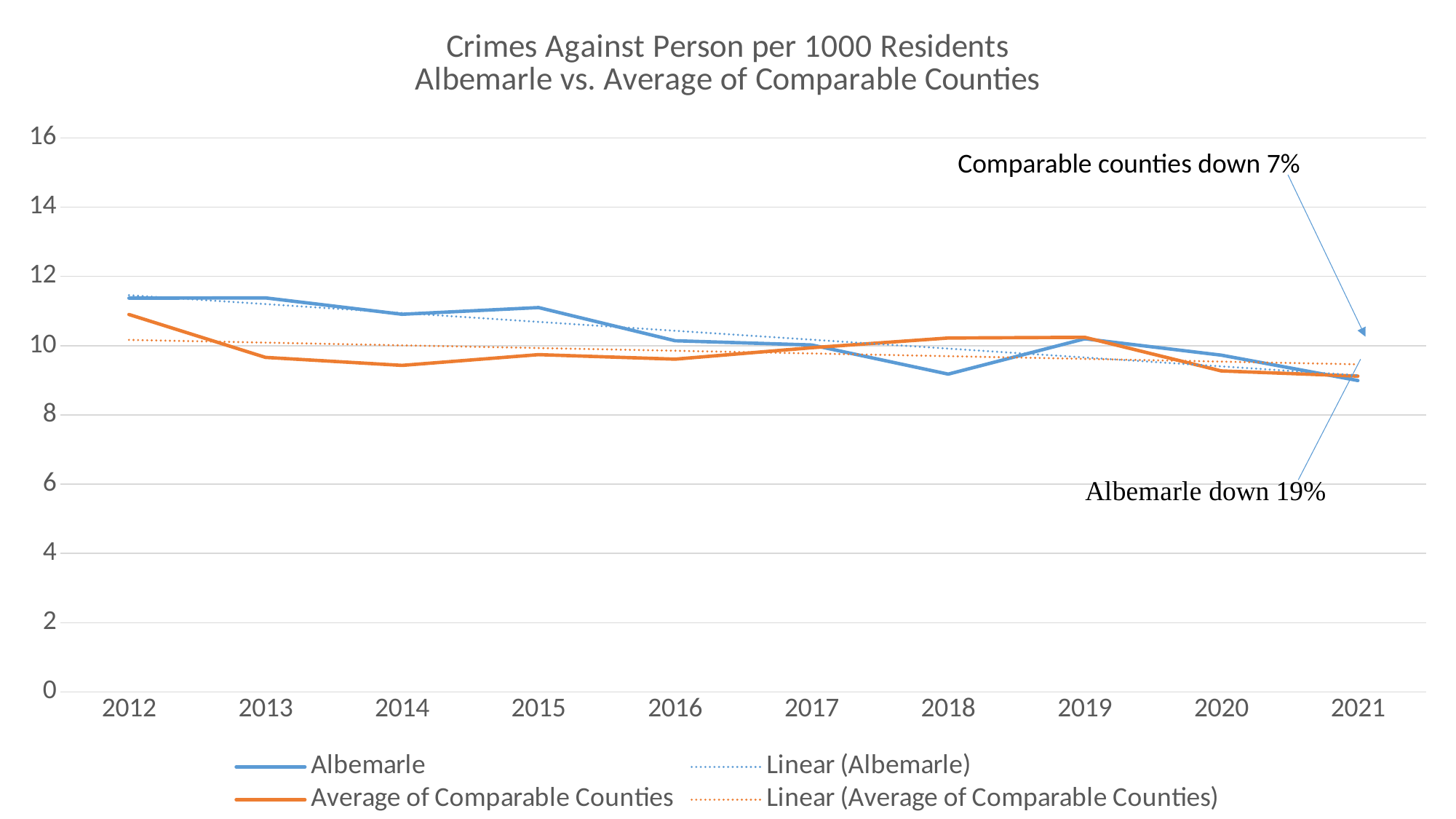
According to the annotation on the chart, by what percentage are comparable counties down? 7% What kind of chart is shown on the slide? line chart How many years are shown along the x axis? 10 Is the Albemarle value for 2021 greater or less than 10? less According to the annotation on the chart, by what percentage is Albemarle down? 19% In which year is the Average of Comparable Counties value highest? 2012 In 2012, which is larger: Albemarle or Average of Comparable Counties? Albemarle How many series does the legend list? 4 Is the Average of Comparable Counties value for 2014 greater or less than 10? less In 2018, which is larger: Albemarle or Average of Comparable Counties? Average of Comparable Counties Does the Albemarle line generally rise or fall from 2012 to 2021? fall Is the Albemarle value for 2012 greater or less than 10? greater